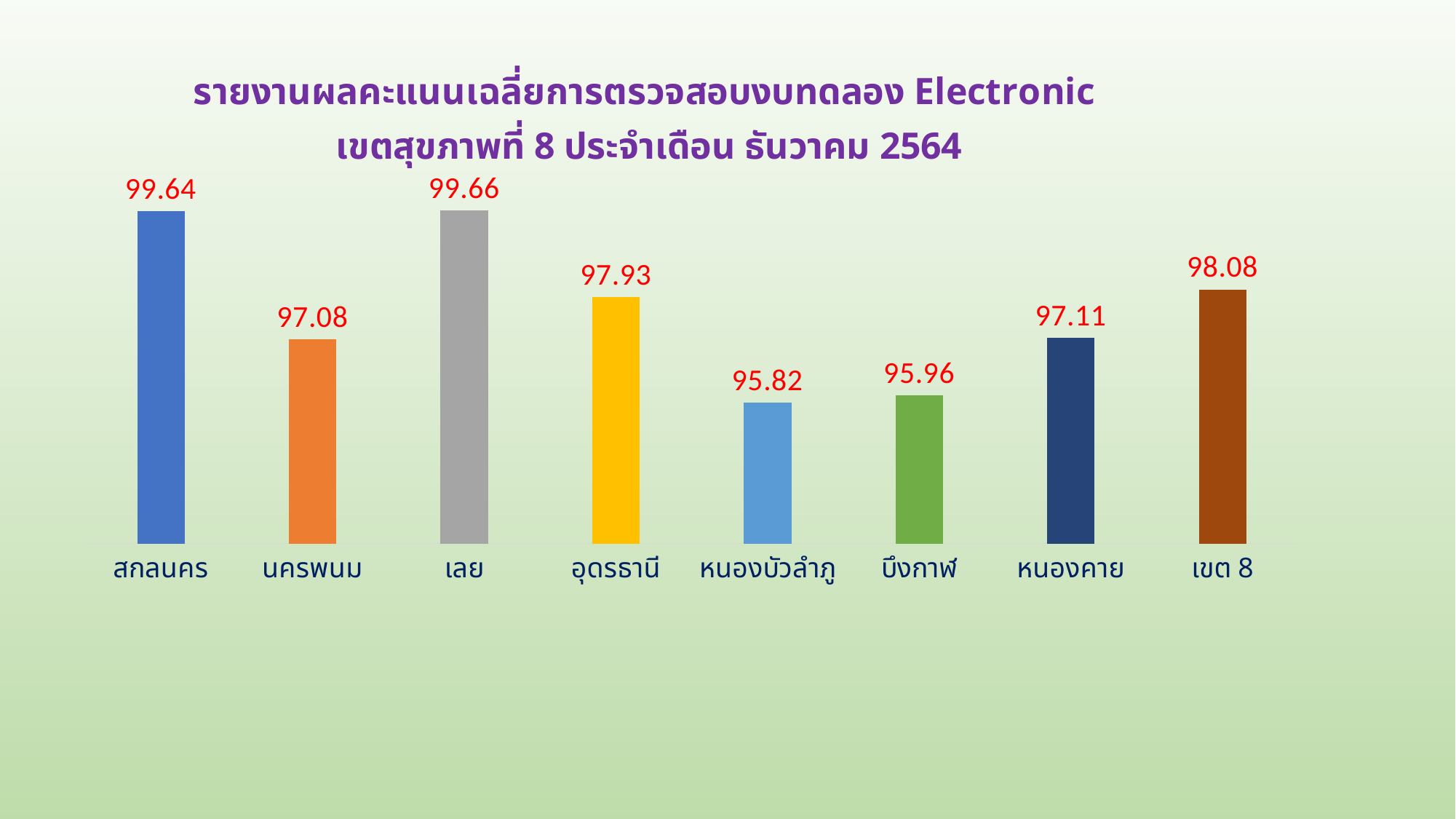
Which category has the highest value? เลย What is the difference between the values for เลย and หนองบัวลำภู? 3.84 What is the value for หนองบัวลำภู? 95.82 What is the difference between the values for เขต 8 and นครพนม? 1.00 What kind of chart is shown on the slide? bar chart Which is larger, the value for อุดรธานี or the value for หนองคาย? อุดรธานี What is the value for เขต 8? 98.08 What is the value for สกลนคร? 99.64 What colour is the bar for เลย? grey Which category has the lowest value? หนองบัวลำภู How many categories are shown in the chart? 8 What is the value for อุดรธานี? 97.93